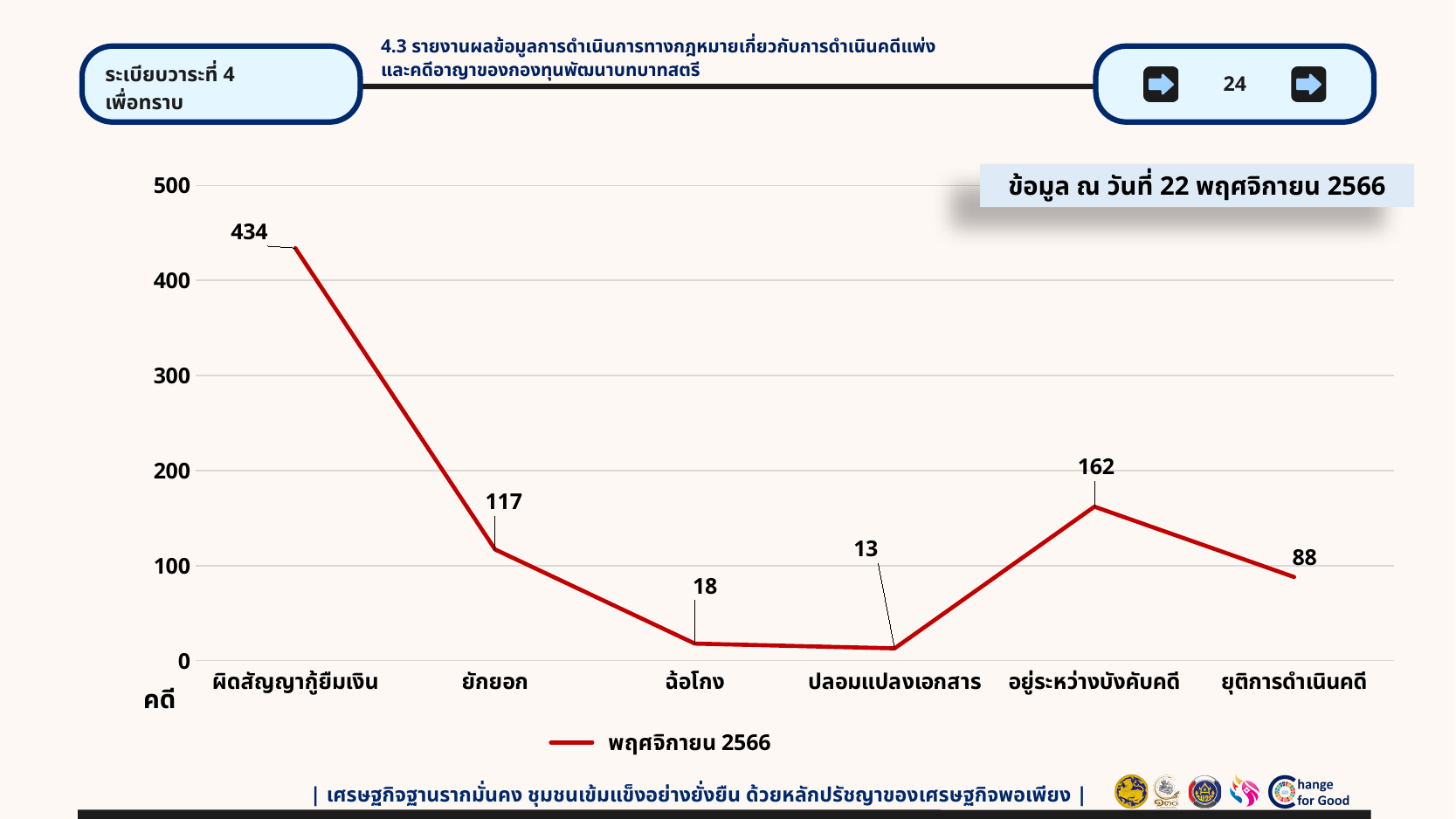
What kind of chart is shown on the slide? line chart How many categories are shown on the x axis? 6 Which category has the lowest value? ปลอมแปลงเอกสาร What is the value for ผิดสัญญากู้ยืมเงิน? 434 Which is larger, the value for ยักยอก or the value for อยู่ระหว่างบังคับคดี? อยู่ระหว่างบังคับคดี What is the difference between the values for อยู่ระหว่างบังคับคดี and ยุติการดำเนินคดี? 74 What is the value for ยักยอก? 117 What is the value for ปลอมแปลงเอกสาร? 13 What series name is shown in the legend? พฤศจิกายน 2566 Which category has the highest value? ผิดสัญญากู้ยืมเงิน How many series does the legend list? 1 What is the value for ยุติการดำเนินคดี? 88